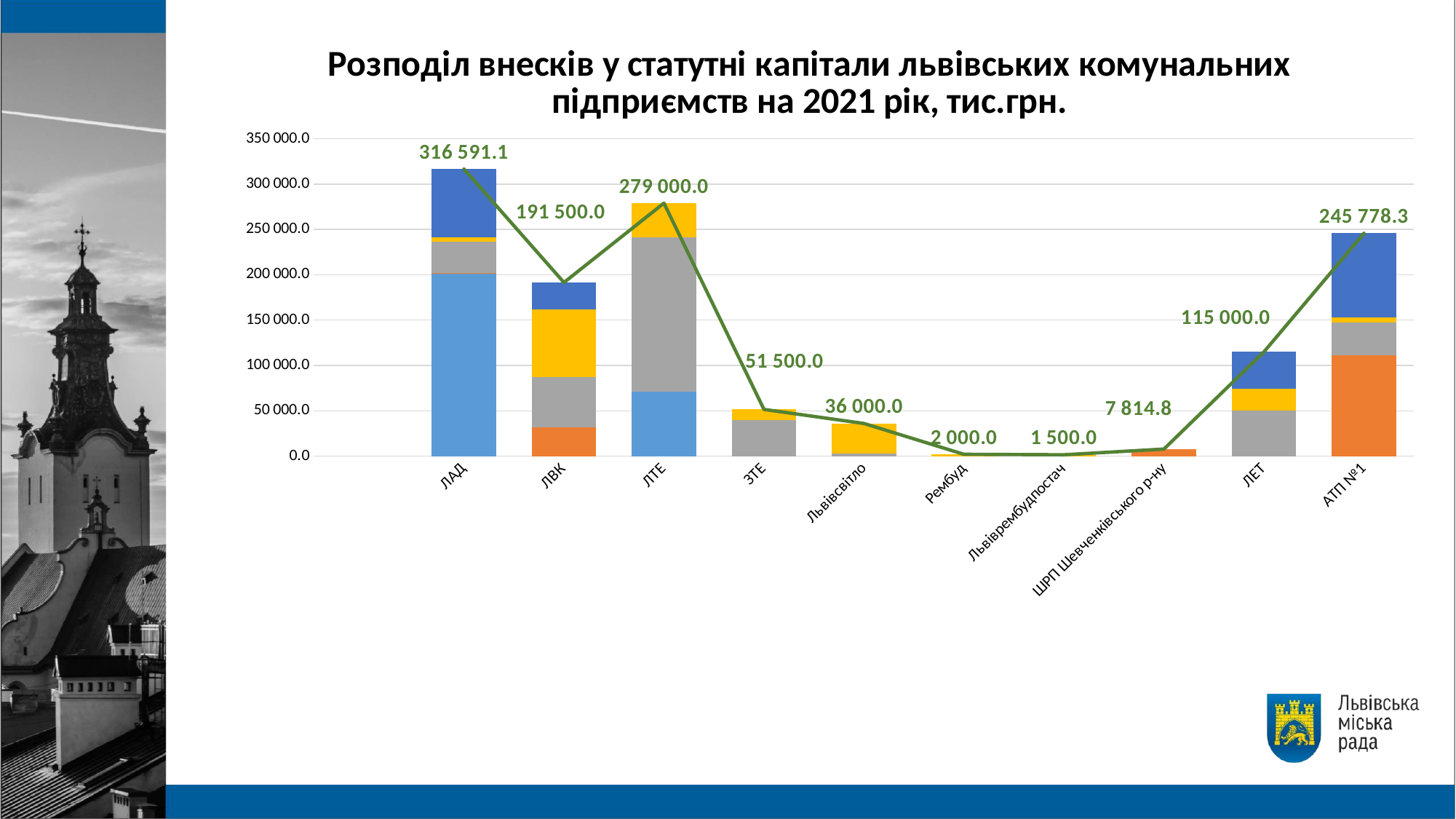
What is the total value shown for ЛАД? 316 591.1 What kind of chart is shown on the slide? Stacked bar chart with a line How many categories are shown on the x axis? 10 What is the total value shown for ШРП Шевченківського р-ну? 7 814.8 What is the title of the chart? Розподіл внесків у статутні капітали львівських комунальних підприємств на 2021 рік, тис.грн. Which category has the lowest total value? Львіврембудпостач What is the total value shown for ЛЕТ? 115 000.0 Which has a larger total value, ЗТЕ or Львівсвітло? ЗТЕ Is the total value for ЛВК greater or less than 200 000.0? less Which category has the highest total value? ЛАД What is the difference between the total values for ЛТЕ and ЛВК? 87 500.0 What is the total value shown for АТП №1? 245 778.3